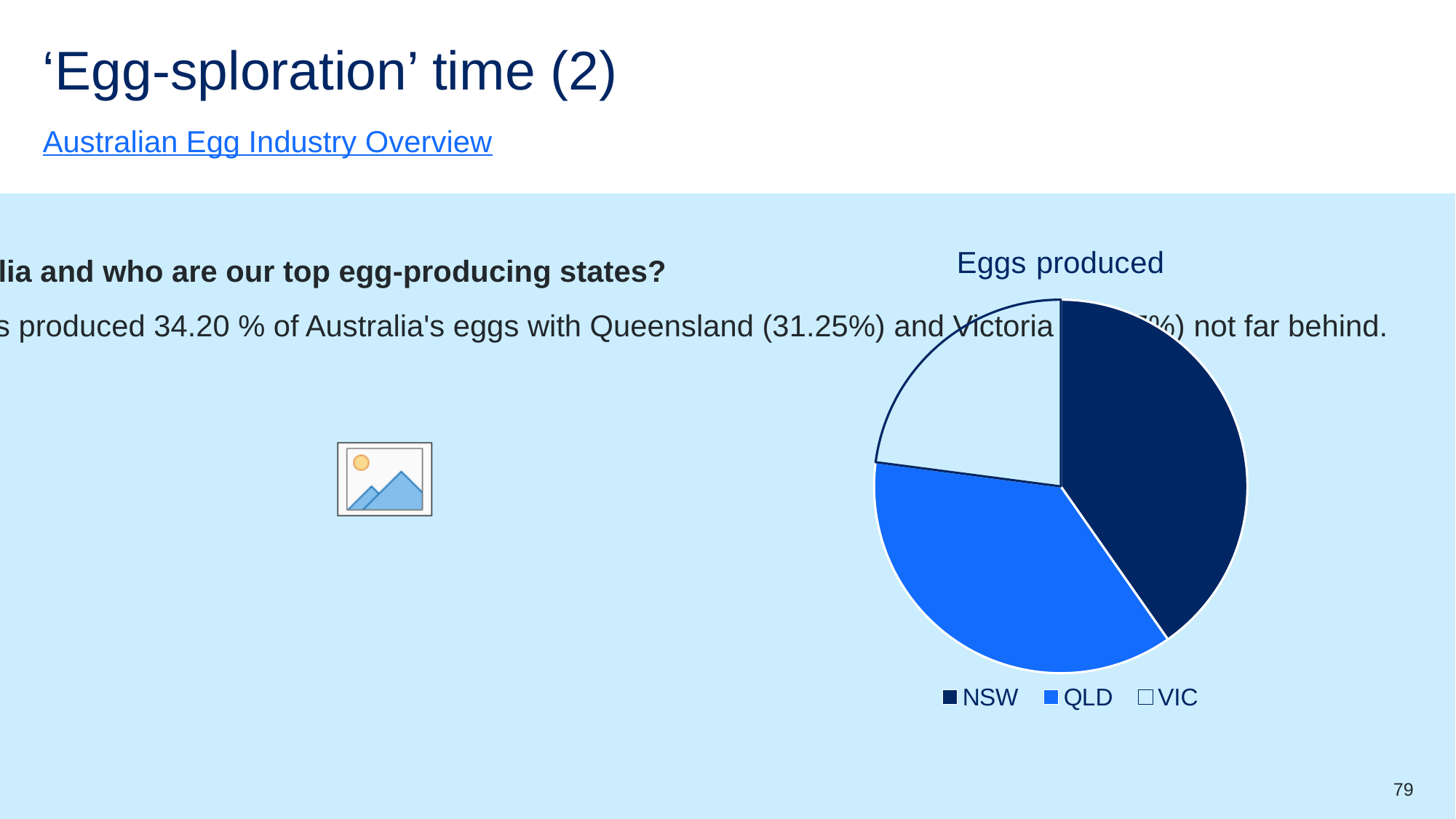
What is the title of the pie chart? Eggs produced Which state is shown in the darkest blue in the 'Eggs produced' pie chart? NSW Which state has the smallest slice in the 'Eggs produced' pie chart? VIC How many entries does the legend of the 'Eggs produced' chart list? 3 What kind of chart is shown on the slide? pie chart In the 'Eggs produced' pie chart, which slice is larger, QLD or VIC? QLD Which states are listed in the legend of the 'Eggs produced' chart? NSW, QLD, VIC In the 'Eggs produced' pie chart, which slice is larger, NSW or VIC? NSW How many slices does the 'Eggs produced' pie chart have? 3